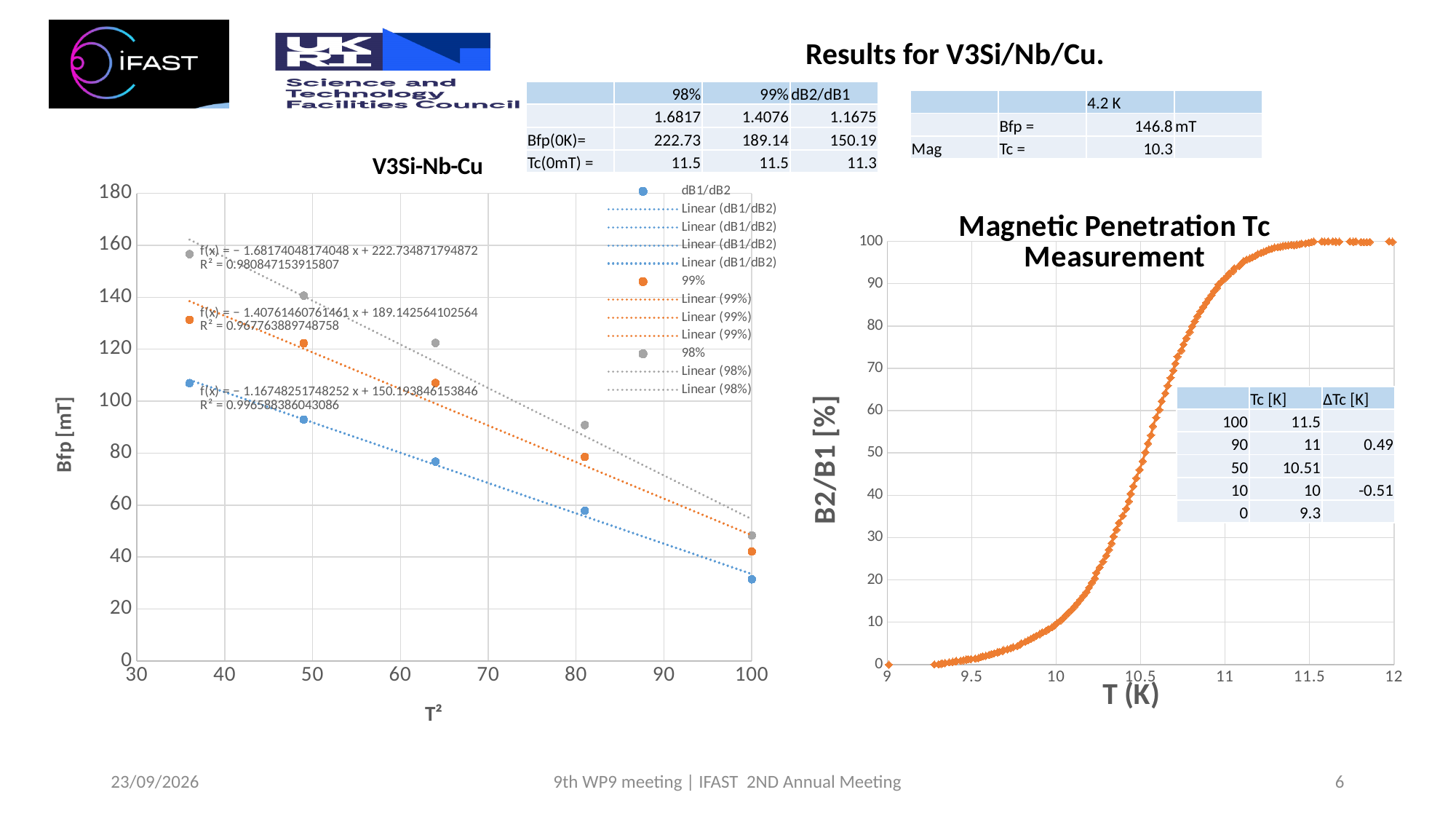
In the 'V3Si-Nb-Cu' chart, do the Bfp values rise or fall as T² increases? fall In the 'Magnetic Penetration Tc Measurement' chart, is the B2/B1 value at T = 11.5 K greater or less than 90? greater In the 'V3Si-Nb-Cu' chart, how many data points does the 98% series have? 5 What is the y-axis title of the 'V3Si-Nb-Cu' chart? Bfp [mT] In the 'V3Si-Nb-Cu' chart, is the dB1/dB2 value at T² = 100 greater or less than 40? less In the 'V3Si-Nb-Cu' chart, how many marker (data point) series are plotted, excluding the linear trendlines? 3 In the 'Magnetic Penetration Tc Measurement' chart, do the B2/B1 values rise or fall as T increases? rise What kind of chart is the 'V3Si-Nb-Cu' chart on the left? scatter chart In the 'V3Si-Nb-Cu' chart, is the 98% value at T² = 36 greater or less than 140? greater In the 'V3Si-Nb-Cu' chart, at T² = 36, which series has the larger value: 98% or 99%? 98% What is the x-axis title of the 'Magnetic Penetration Tc Measurement' chart? T (K) In the 'V3Si-Nb-Cu' chart, which series has the highest value at T² = 100? 98%